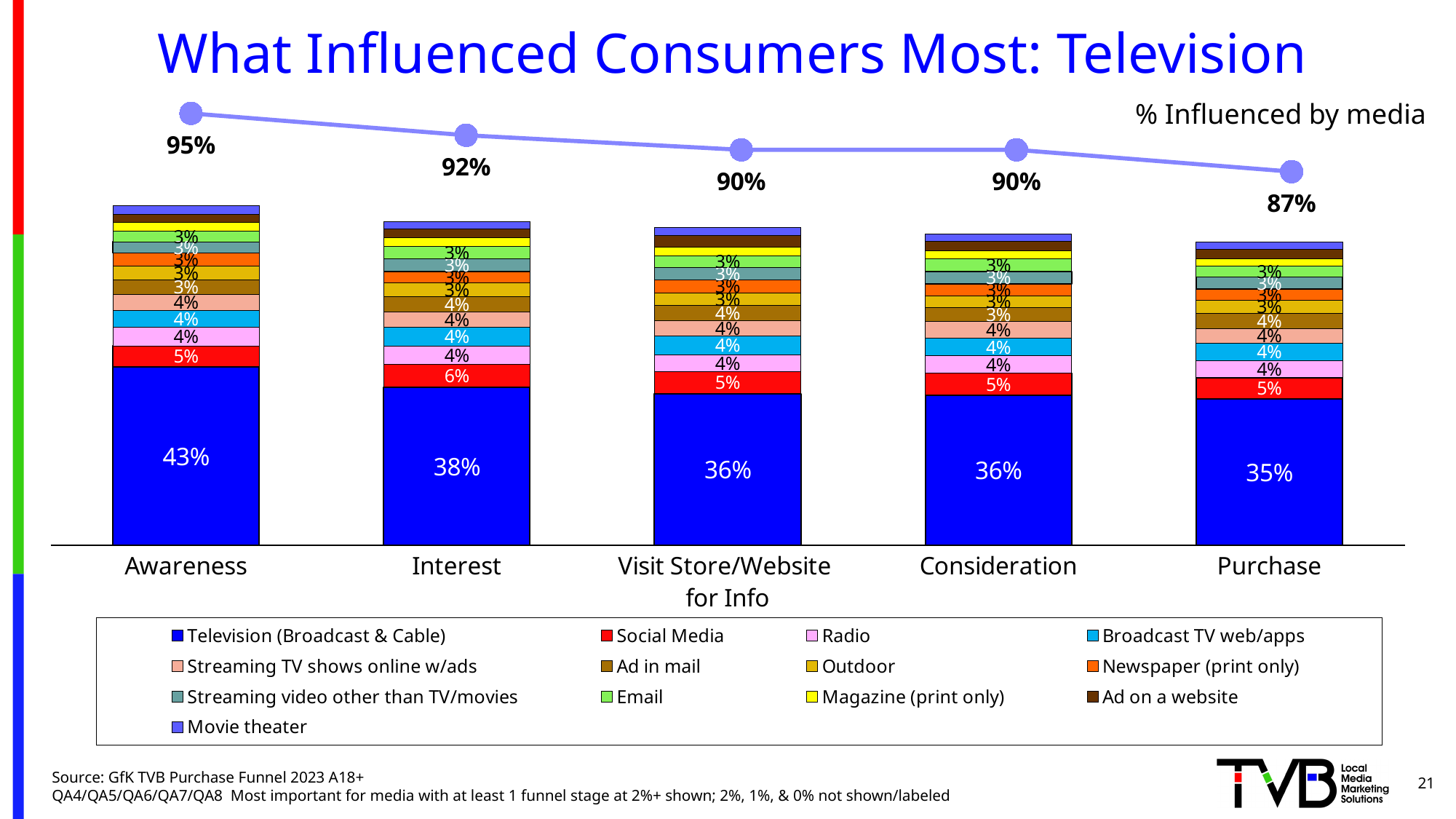
How much higher is the Television (Broadcast & Cable) value at Awareness than at Purchase? 8 percentage points At which funnel stage is the Television (Broadcast & Cable) share lowest? Purchase What is the % Influenced by media value for the Purchase stage? 87% How many series does the legend list? 13 What kind of chart is shown on the slide? Stacked bar chart with a line overlay Does the % Influenced by media line rise or fall from Awareness to Purchase? Fall What is the Social Media value for the Interest stage? 6% How many funnel stages are shown on the x axis? 5 What is the Television (Broadcast & Cable) value for the Awareness stage? 43% What is the % Influenced by media value for the Awareness stage? 95% At which funnel stage is the Television (Broadcast & Cable) share highest? Awareness Is the Social Media value larger at Interest or at Awareness? Interest